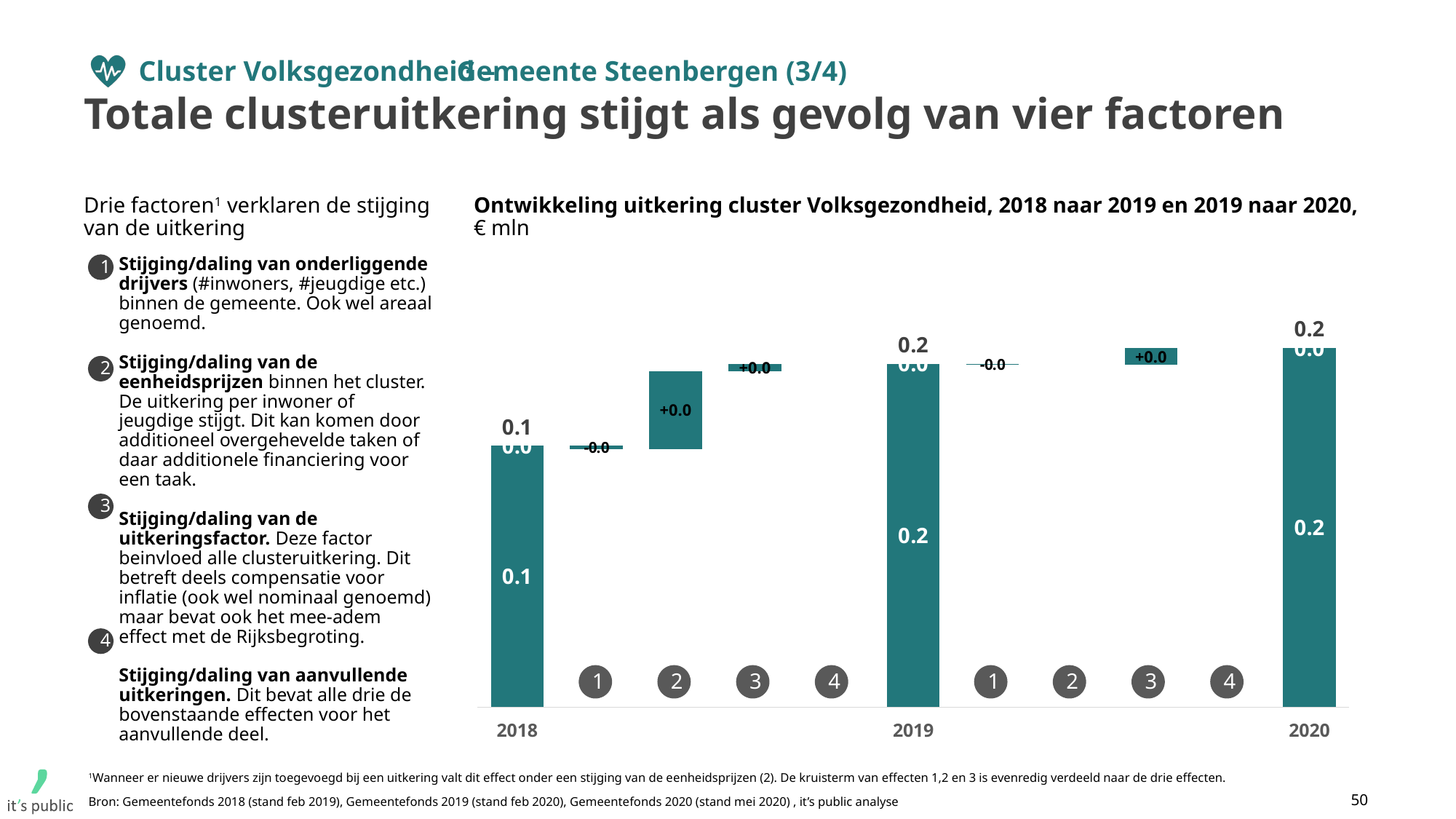
What is the value labelled for factor 2 between 2018 and 2019? +0.0 What is the value labelled for factor 1 between 2018 and 2019? -0.0 How many year totals are shown in the chart? 3 Which year has the lowest total uitkering? 2018 What is the total uitkering for 2018 shown above the bar? 0.1 What is the total uitkering for 2020 shown above the bar? 0.2 In what unit are the values in the chart expressed? € mln What is the difference between the total for 2019 and the total for 2018? 0.1 What is the total uitkering for 2019 shown above the bar? 0.2 Does the total uitkering rise or fall from 2018 to 2020? rise Which is larger, the total for 2018 or the total for 2019? 2019 What kind of chart is shown on the slide? bar chart